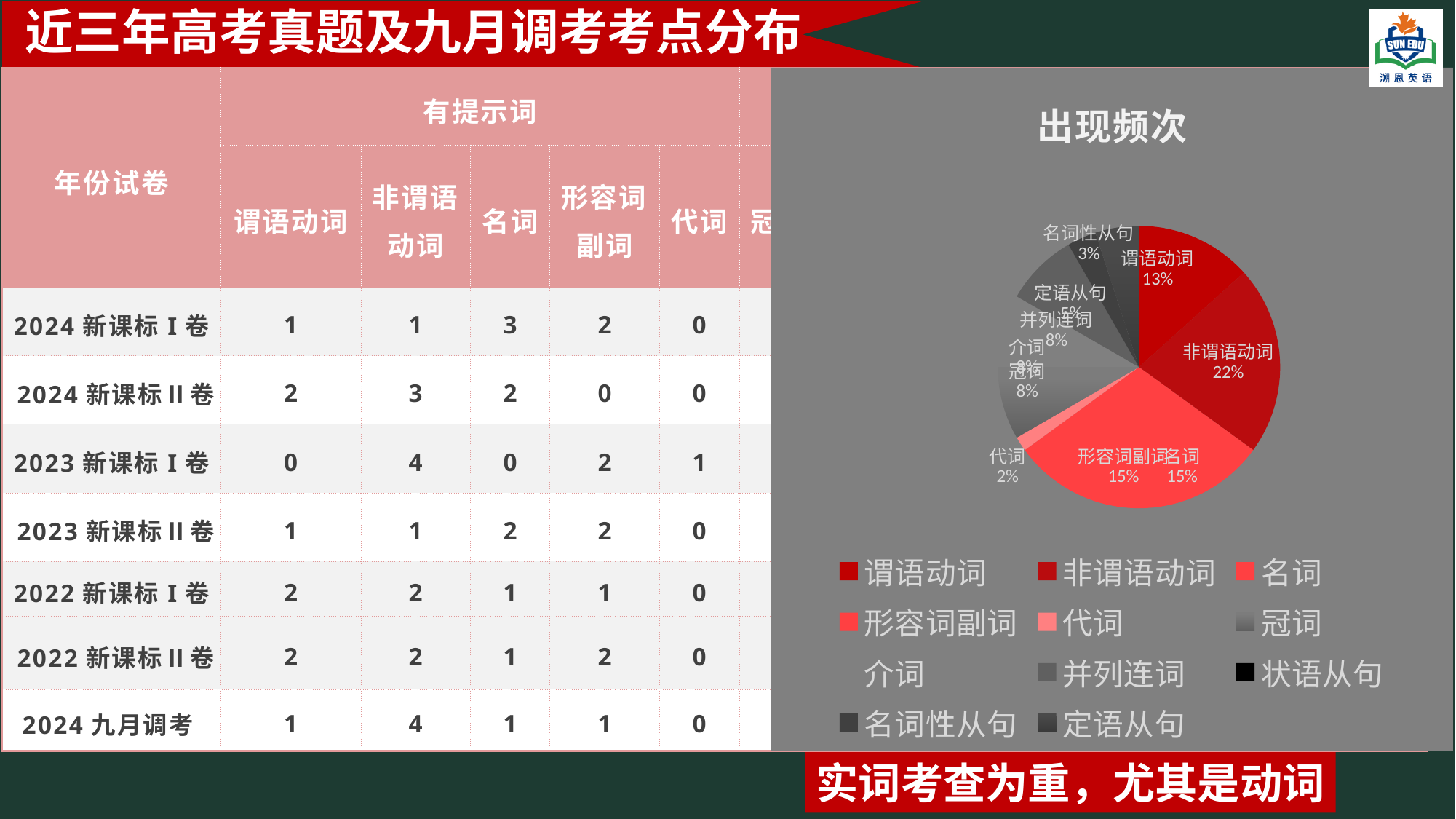
How many entries does the legend list? 11 Which category has the largest share of the pie? 非谓语动词 Which has a larger share, 名词 or 谓语动词? 名词 What is the title of the chart? 出现频次 What kind of chart is shown on the slide? pie chart What share of the pie does 谓语动词 have? 13% What share of the pie does 名词性从句 have? 3% What share of the pie does 代词 have? 2% What share of the pie does 非谓语动词 have? 22% What share of the pie does 定语从句 have? 5% What is the difference in percentage points between 非谓语动词 and 谓语动词? 9